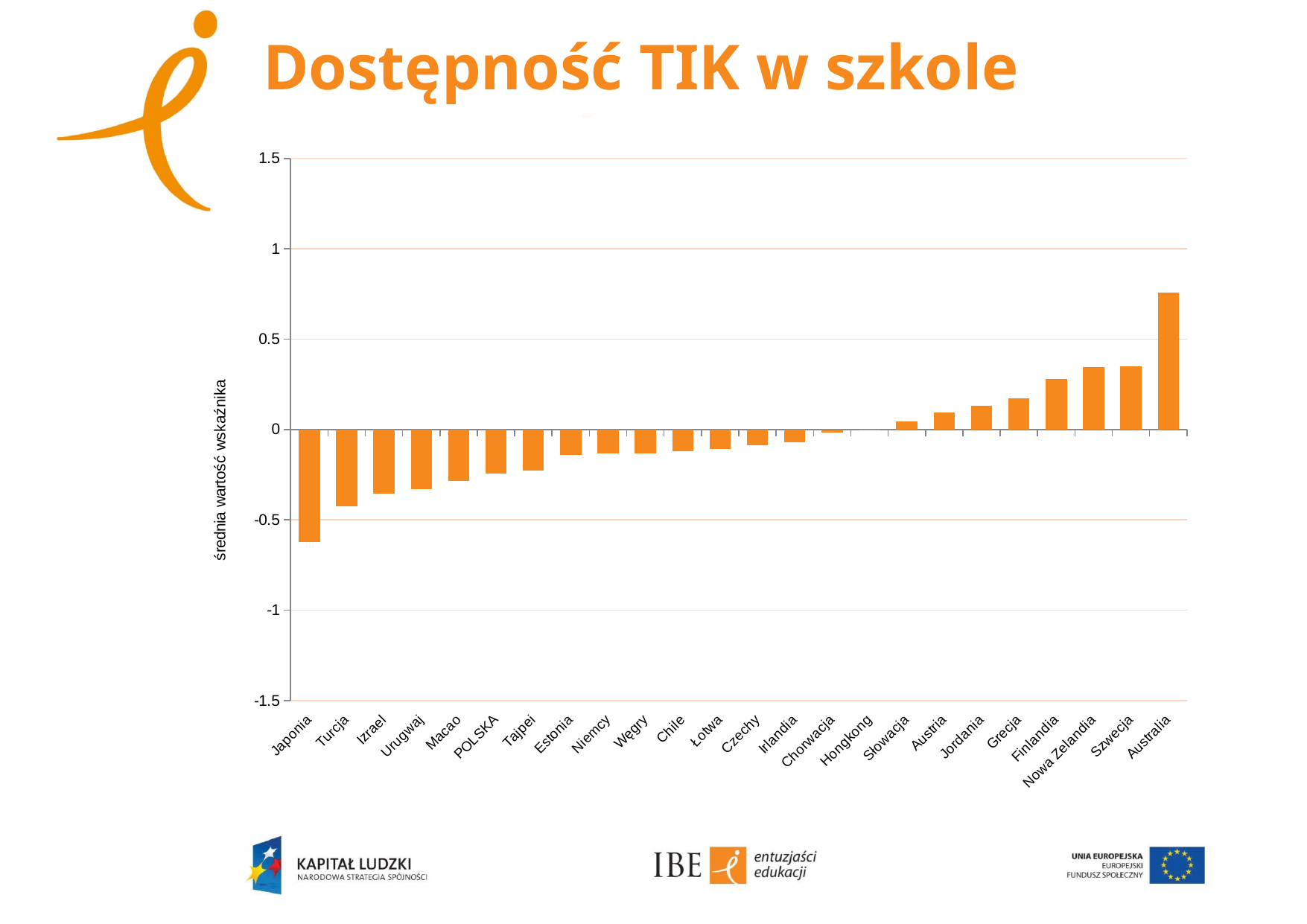
Which has the larger value, Australia or Szwecja? Australia Do the values rise or fall moving from left to right along the x axis? rise Is the value for Turcja greater or less than -0.5? greater Which country has the lowest value in the chart? Japonia Which country has the highest value in the chart? Australia Is the value for Japonia greater or less than -0.5? less What kind of chart is shown on the slide? bar chart Which has the larger value, POLSKA or Japonia? POLSKA Is the value for Australia greater or less than 0.5? greater What is the title of the slide containing the chart? Dostępność TIK w szkole How many countries/regions are shown on the x axis of the chart? 24